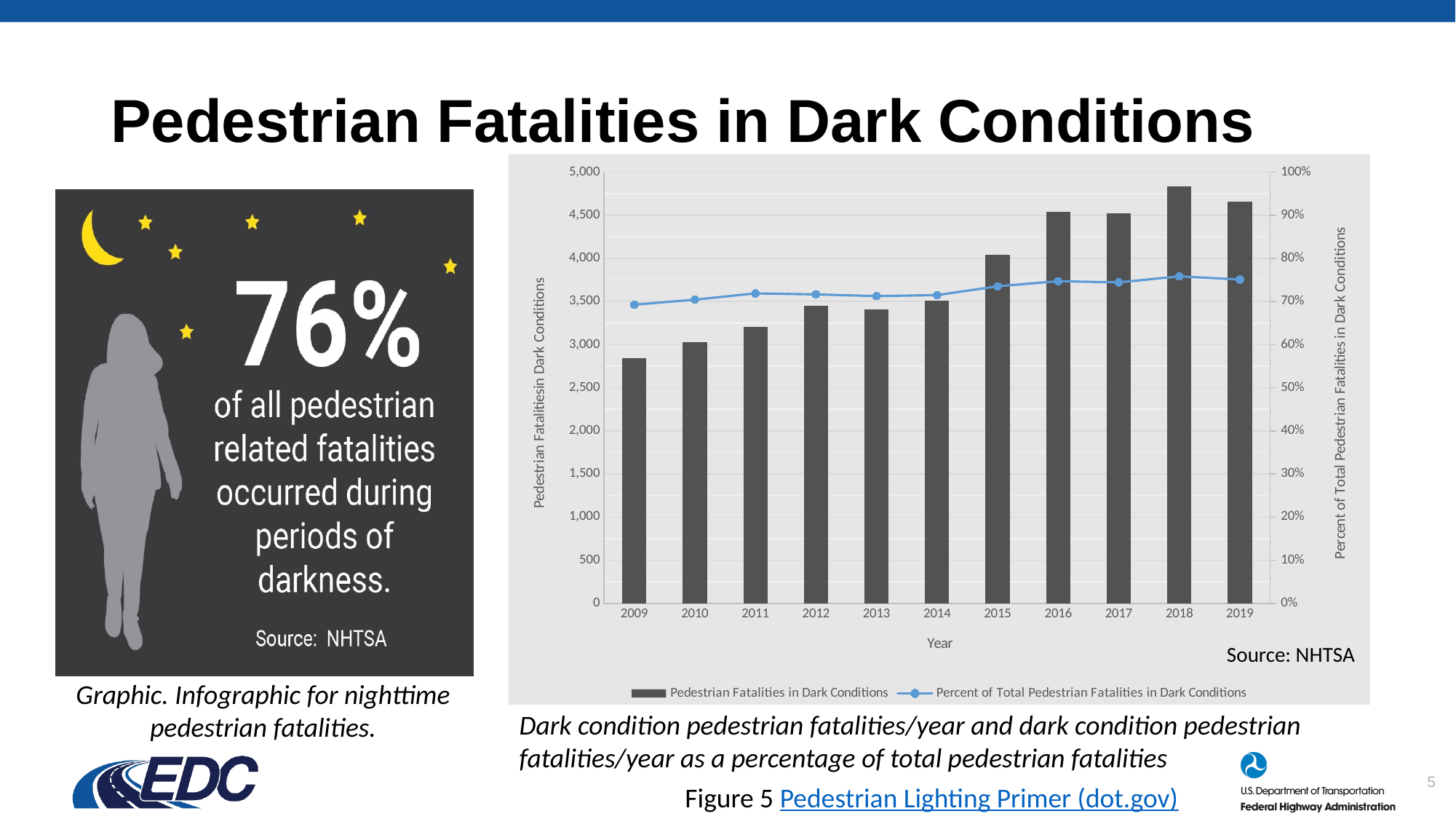
How many series does the chart legend list? 2 Which year has the larger bar for Pedestrian Fatalities in Dark Conditions, 2011 or 2019? 2019 How many years are shown on the x axis of the chart? 11 Overall, do the bars for Pedestrian Fatalities in Dark Conditions rise or fall from 2009 to 2019? rise Which year has the lowest bar for Pedestrian Fatalities in Dark Conditions? 2009 Which year has the highest bar for Pedestrian Fatalities in Dark Conditions? 2018 What is the title of the right-hand vertical axis of the chart? Percent of Total Pedestrian Fatalities in Dark Conditions What kind of chart is shown on the right side of the slide? A combined bar and line chart Is the bar for Pedestrian Fatalities in Dark Conditions in 2015 greater or less than 4,500? less Is the Percent of Total Pedestrian Fatalities in Dark Conditions in 2009 greater or less than 60%? greater Is the bar for Pedestrian Fatalities in Dark Conditions in 2016 greater or less than 4,000? greater